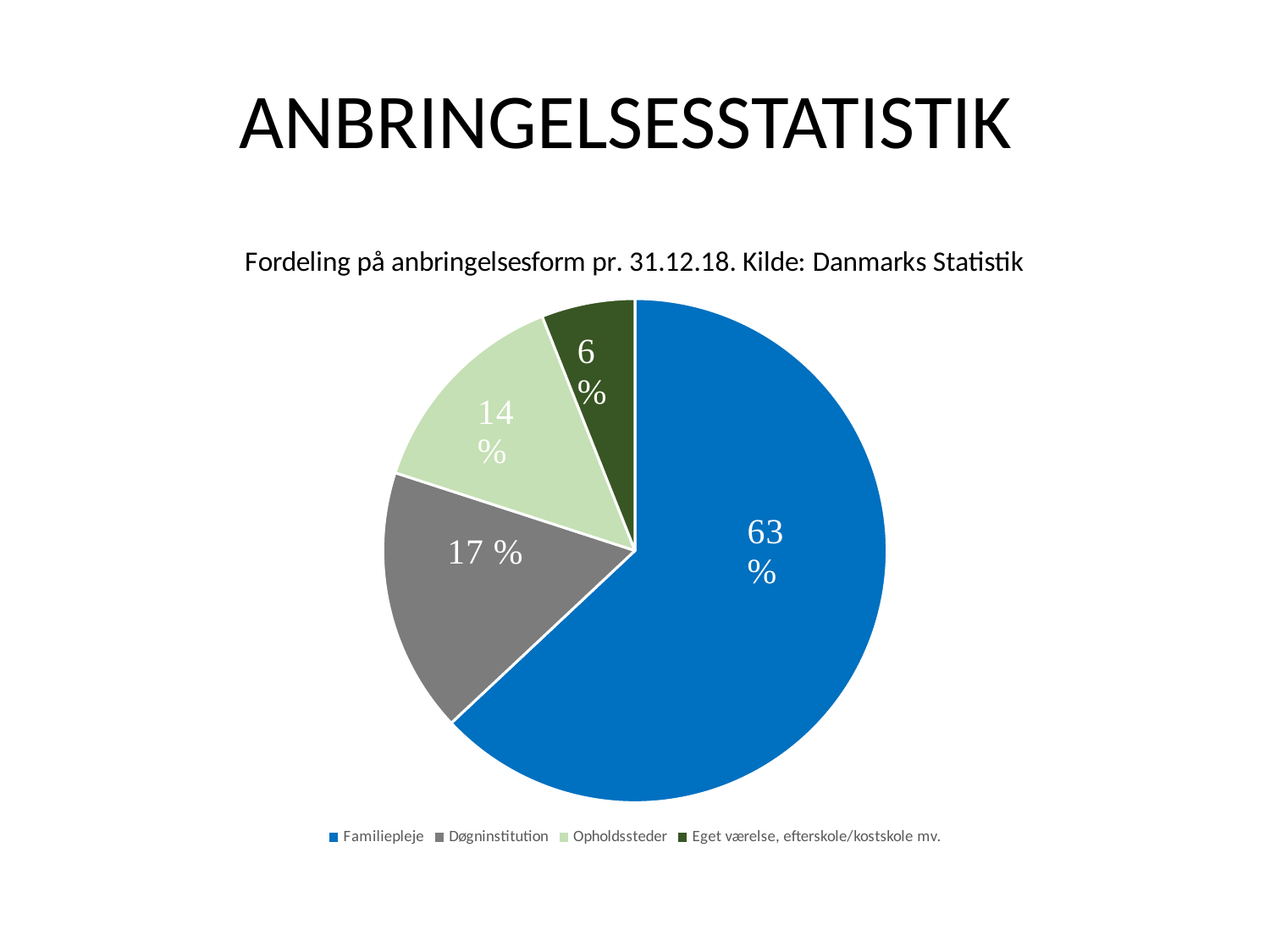
What kind of chart is shown on the slide? Pie chart What is the title of the chart? Fordeling på anbringelsesform pr. 31.12.18. Kilde: Danmarks Statistik Which category has the smallest slice of the pie? Eget værelse, efterskole/kostskole mv. Which category has the largest slice of the pie? Familiepleje Which is larger, the share for Opholdssteder or the share for Eget værelse, efterskole/kostskole mv.? Opholdssteder What is the difference in percentage points between Døgninstitution and Opholdssteder? 3 What percentage is shown for Eget værelse, efterskole/kostskole mv.? 6 % What share of the pie does Familiepleje account for? 63 % What percentage is shown for Døgninstitution? 17 % How many categories does the pie chart show? 4 What is the difference in percentage points between Familiepleje and Døgninstitution? 46 What percentage is shown for Opholdssteder? 14 %